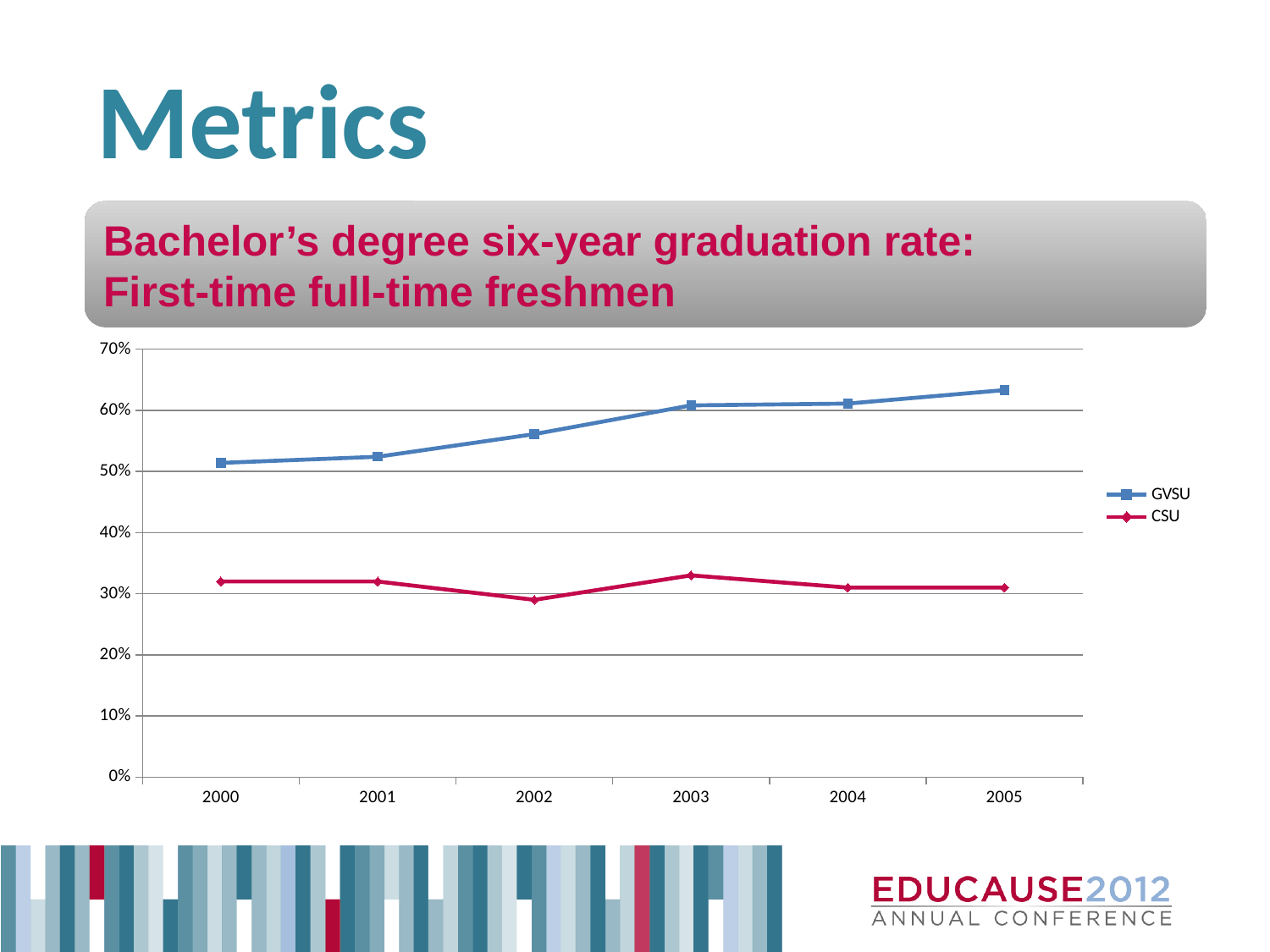
Is the CSU value for 2005 greater or less than 40%? less How many series does the legend list? 2 In which year is the CSU graduation rate lowest? 2002 Is the GVSU value for 2005 greater or less than 60%? greater Is the GVSU value for 2002 greater or less than 50%? greater In which year is the GVSU graduation rate highest? 2005 How many years are shown along the x axis? 6 Which two series are listed in the legend? GVSU and CSU Does the GVSU line generally rise or fall from 2000 to 2005? Rise In 2003, which series has the higher graduation rate, GVSU or CSU? GVSU What kind of chart is shown on the slide? Line chart What is the title shown above the chart? Bachelor's degree six-year graduation rate: First-time full-time freshmen